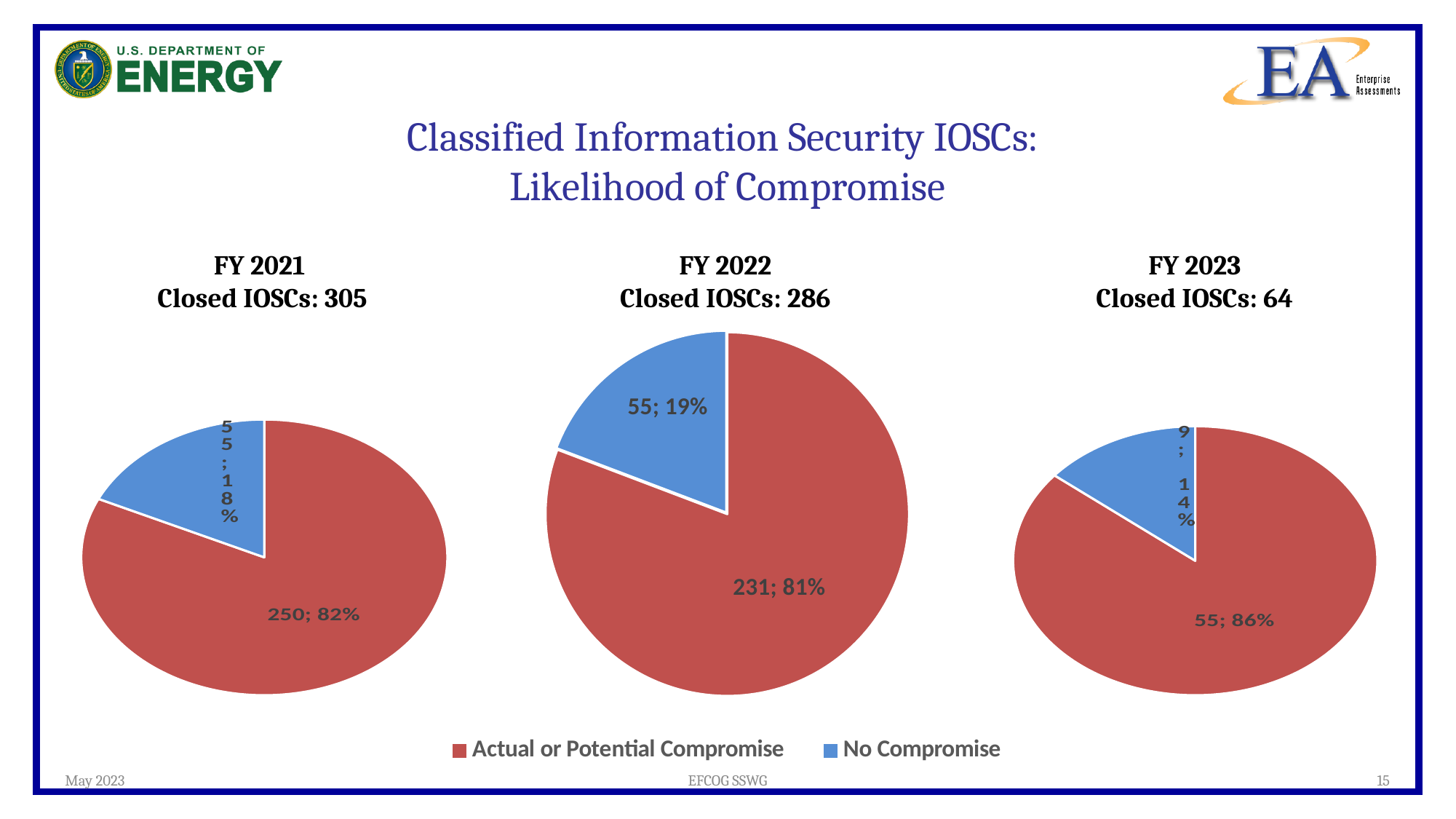
In the FY 2022 pie chart, which category is the largest? Actual or Potential Compromise What kind of chart is used for FY 2022? pie chart In the FY 2023 pie chart, how many closed IOSCs were No Compromise? 9 In the FY 2022 pie chart, what percentage of closed IOSCs were No Compromise? 19% In the FY 2021 pie chart, how many closed IOSCs were Actual or Potential Compromise? 250 In the FY 2023 pie chart, what share of closed IOSCs were Actual or Potential Compromise? 86% In the FY 2021 pie chart, which category is the smallest? No Compromise In the FY 2022 pie chart, what is the difference between the Actual or Potential Compromise count and the No Compromise count? 176 What is the total number of closed IOSCs shown for FY 2022? 286 In the FY 2021 pie chart, is the No Compromise count larger or smaller than the Actual or Potential Compromise count? smaller How many entries does the legend list? 2 How many slices does the FY 2023 pie chart have? 2